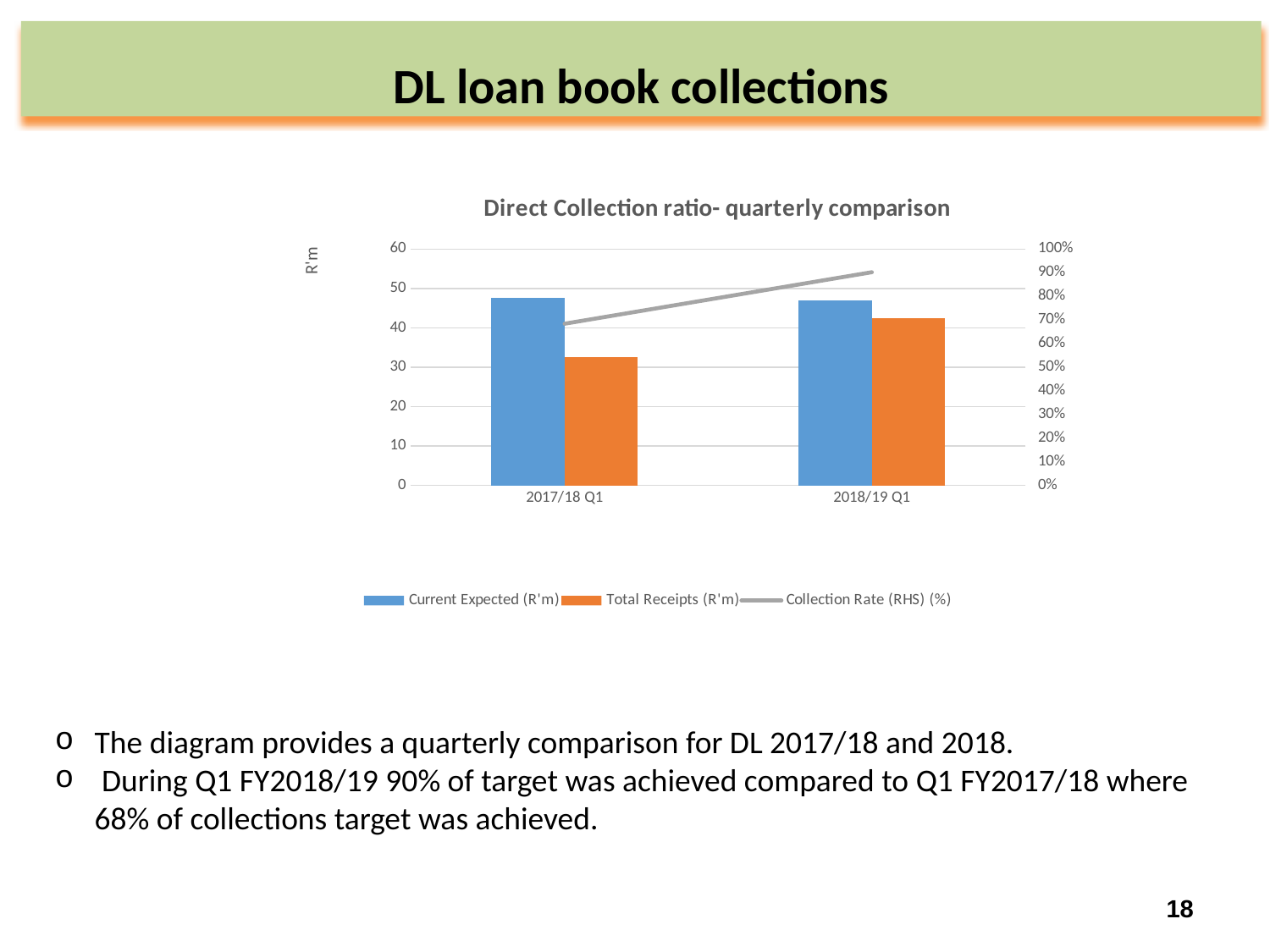
What is the title of the chart? Direct Collection ratio- quarterly comparison Is the Total Receipts (R'm) value for 2018/19 Q1 greater or less than 40? greater In 2017/18 Q1, which is larger, Current Expected (R'm) or Total Receipts (R'm)? Current Expected (R'm) How many quarters are shown on the x axis of the chart? 2 Does the Collection Rate line rise or fall from 2017/18 Q1 to 2018/19 Q1? Rise Is the Collection Rate for 2018/19 Q1 greater or less than 80%? greater Which quarter has the higher Total Receipts (R'm), 2017/18 Q1 or 2018/19 Q1? 2018/19 Q1 Is the Current Expected (R'm) value for 2017/18 Q1 greater or less than 40? greater What kind of chart is used for the Current Expected and Total Receipts series? Bar chart How many series does the chart legend list? 3